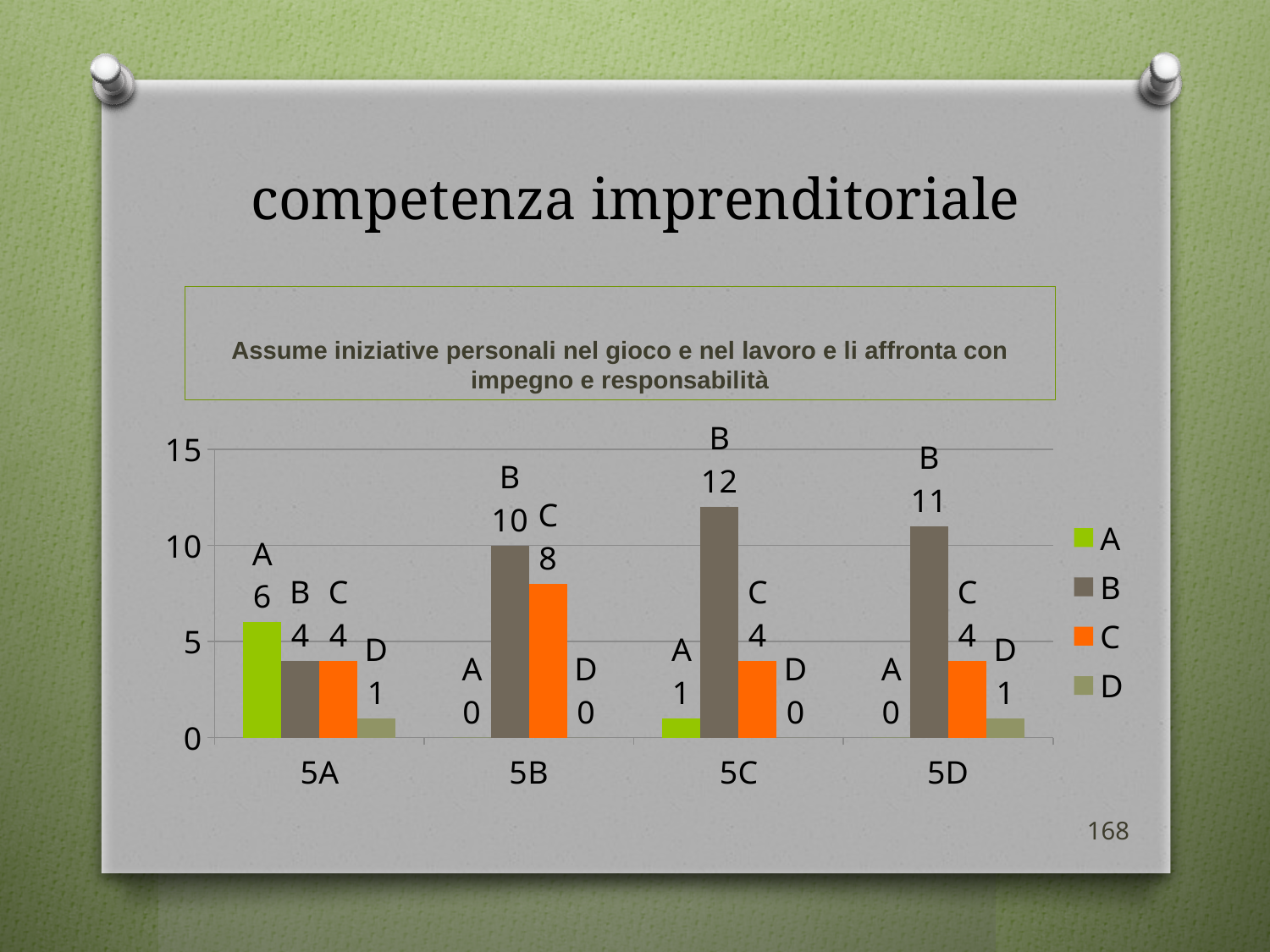
What is the difference between the value for B in 5C and the value for B in 5D? 1 How many categories are shown on the x axis? 4 Which is larger: the value for C in 5B or the value for C in 5A? C in 5B What is the value for series D in category 5D? 1 How many series does the legend list? 4 What kind of chart is shown on the slide? bar chart What is the value for series B in category 5C? 12 What is the title of the slide? competenza imprenditoriale Which category has the highest value for series B? 5C Which category has the lowest value for series B? 5A What is the value for series C in category 5B? 8 What is the value for series A in category 5A? 6